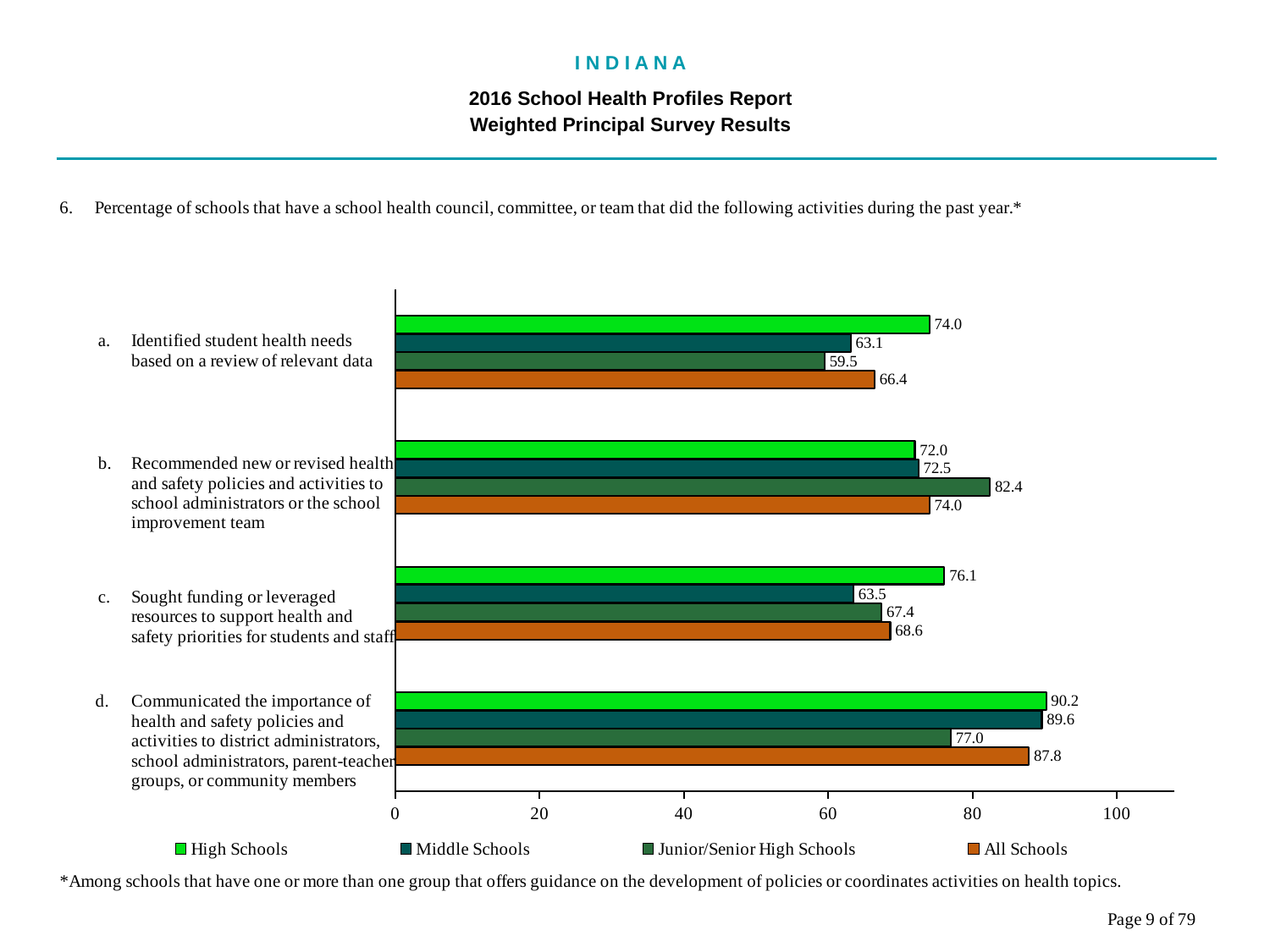
What is the value for Junior/Senior High Schools for activity b, recommended new or revised health and safety policies? 82.4 How many activities (categories) are shown on the chart? 4 Which school type has the lowest value for activity a, identified student health needs? Junior/Senior High Schools What is the value for Middle Schools for activity d, communicated the importance of health and safety policies? 89.6 What is the difference between the High Schools and Middle Schools values for activity a, identified student health needs? 10.9 For activity b, which is larger: the Junior/Senior High Schools value or the All Schools value? Junior/Senior High Schools What kind of chart is shown on the slide? Bar chart Which activity has the highest value for High Schools? d. Communicated the importance of health and safety policies and activities What is the value for All Schools for activity c, sought funding or leveraged resources? 68.6 Is the value for Junior/Senior High Schools for activity d greater or less than 80? less What is the value for High Schools for activity a, identified student health needs based on a review of relevant data? 74.0 How many series does the legend list? 4